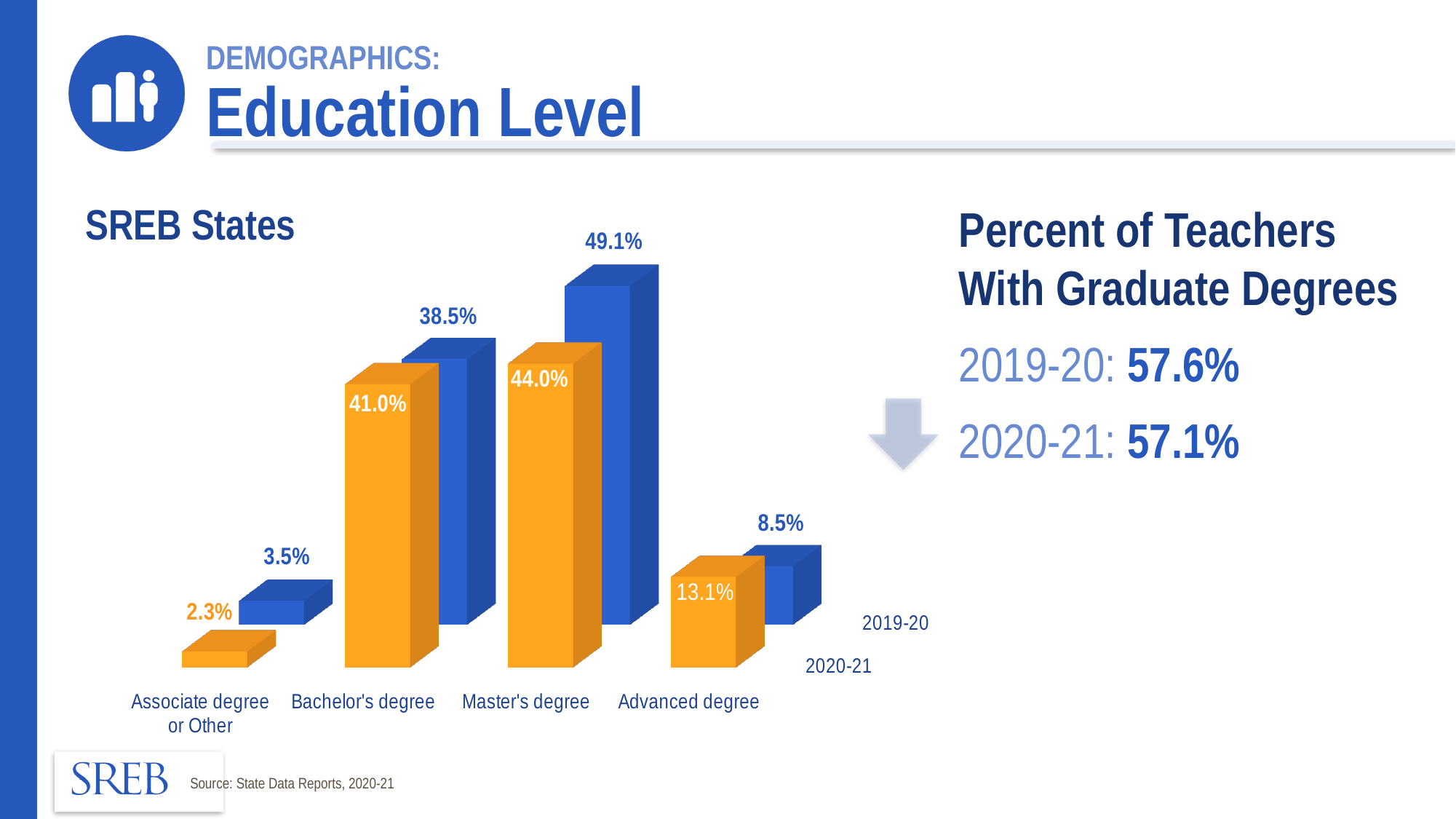
For Bachelor's degree, which is larger: the 2019-20 value or the 2020-21 value? 2020-21 What is the difference between the 2020-21 and 2019-20 values for Advanced degree? 4.6% What is the 2019-20 value for Master's degree? 49.1% What kind of chart is shown on the slide? Bar chart What is the 2020-21 value for Bachelor's degree? 41.0% What is the difference between the 2019-20 and 2020-21 values for Master's degree? 5.1% Which category has the lowest 2019-20 value? Associate degree or Other What is the 2020-21 value for Associate degree or Other? 2.3% How many data series does the chart show? 2 What is the 2019-20 value for Advanced degree? 8.5% How many degree categories are shown on the x axis? 4 Which category has the highest 2020-21 value? Master's degree